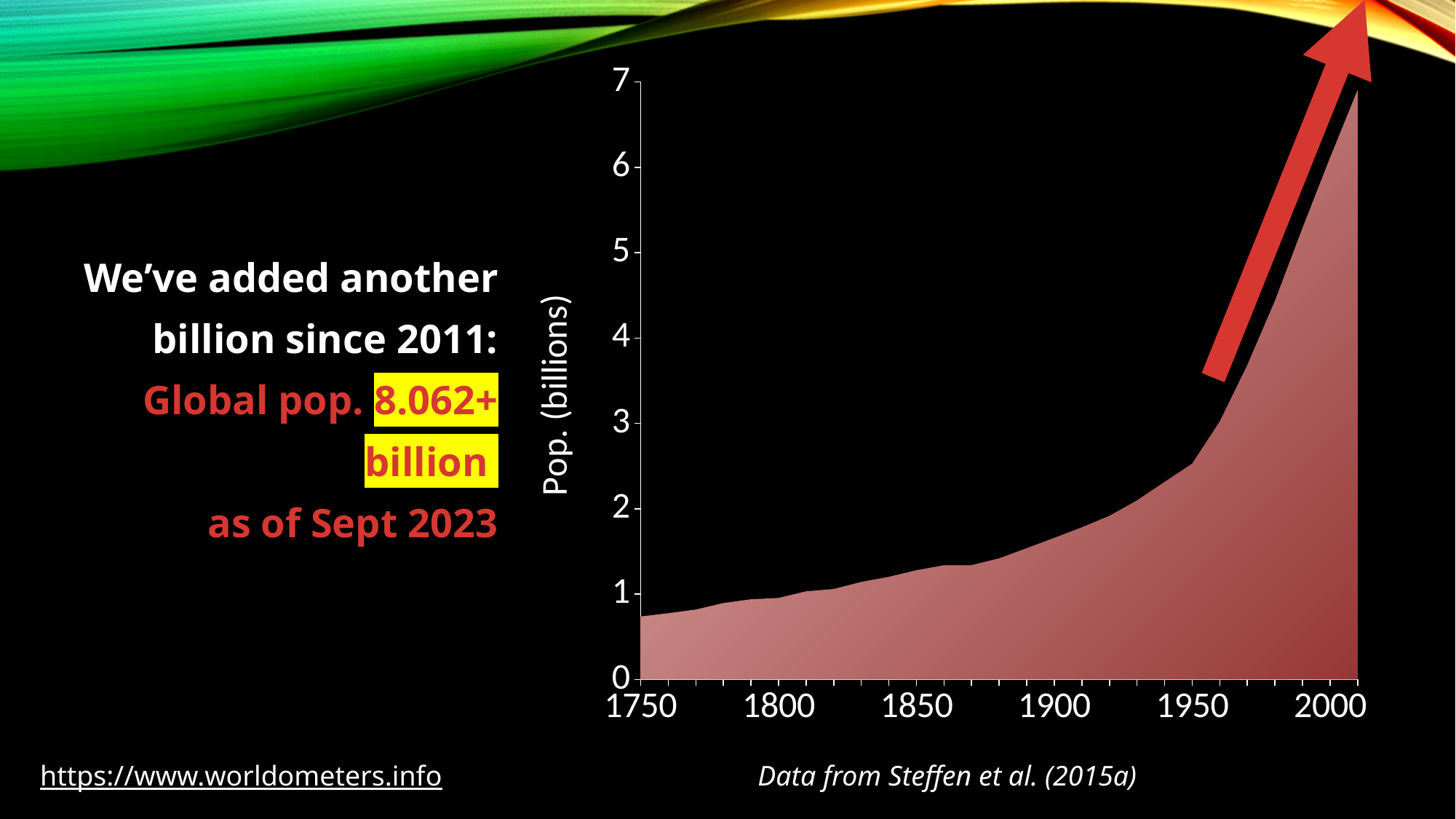
What kind of chart is shown on the slide? area chart Is the population value for 2000 greater or less than 5 billion? greater What is the label on the y axis of the chart? Pop. (billions) What is the highest value shown on the y axis of the chart? 7 Is the population value for 1750 greater or less than 1 billion? less Which labelled year on the x axis has the lowest population value? 1750 Which year has the larger population value, 1800 or 1950? 1950 Does the population value rise or fall from 1750 to 2000 along the x axis? rise Is the population value for 1850 greater or less than 1 billion? greater Which labelled year on the x axis has the highest population value? 2000